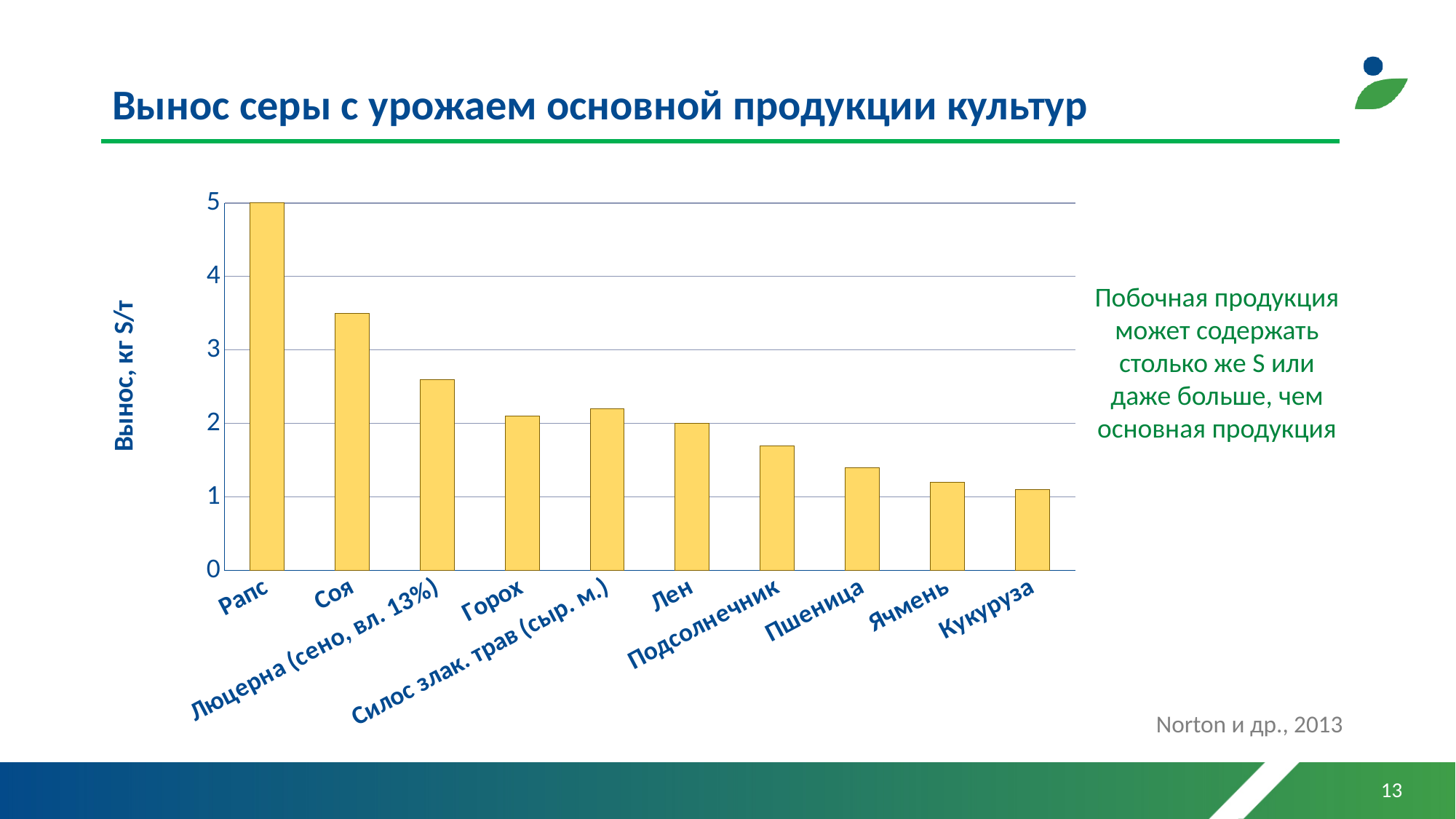
What is the value for Рапс, in кг S/т? 5 Is the value for Подсолнечник greater or less than 2? less Which crop has the highest sulfur removal value on the chart? Рапс How many crops (categories) are plotted on the chart? 10 What is the value for Лен, in кг S/т? 2 Is the value for Пшеница greater or less than 1? greater What kind of chart is shown on the slide? bar chart Do the bar values generally rise or fall from left to right along the x axis? fall What is the label of the vertical axis? Вынос, кг S/т Is the value for Люцерна (сено, вл. 13%) greater or less than 2? greater Which has a larger value, Соя or Люцерна (сено, вл. 13%)? Соя